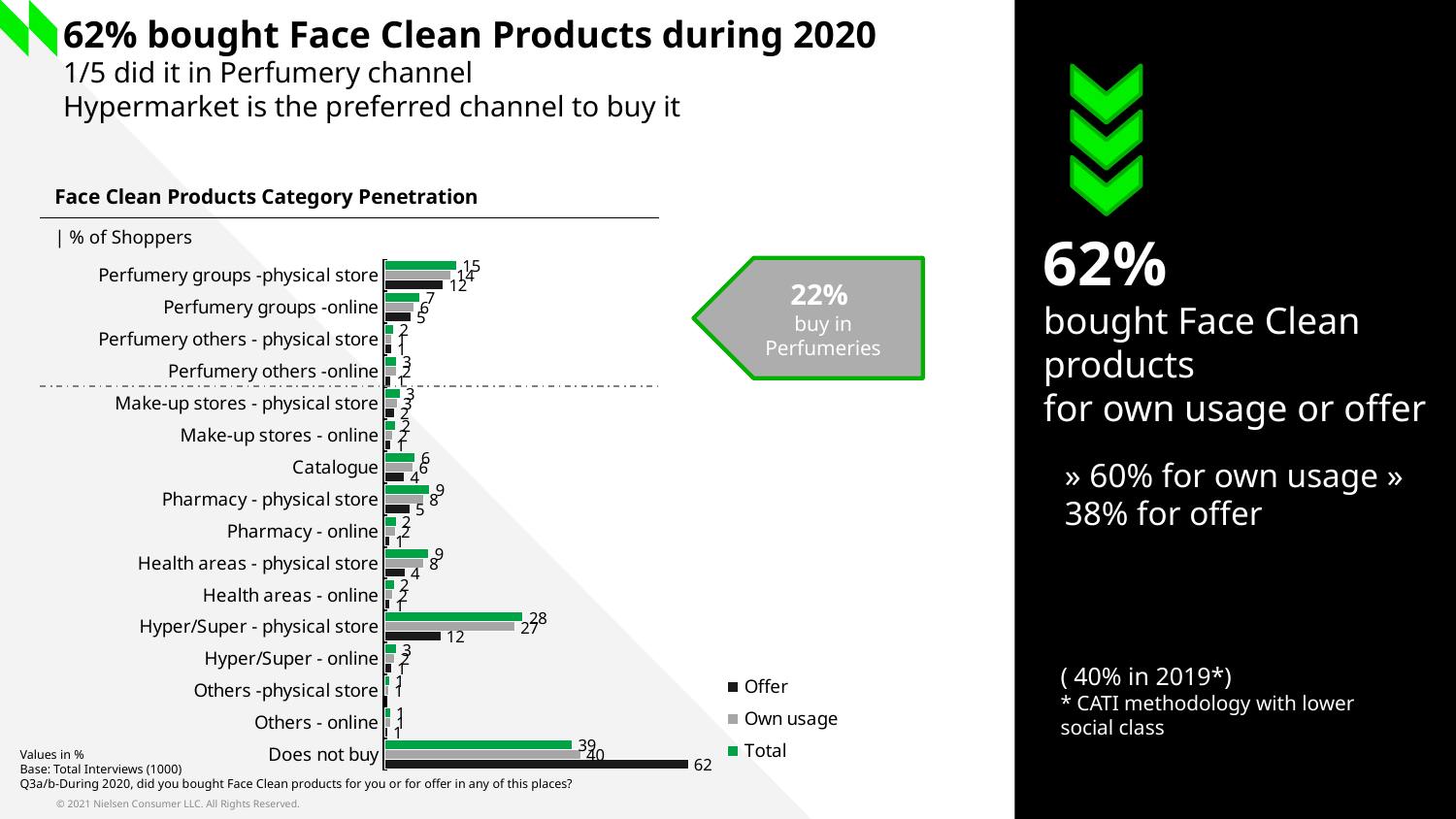
What is the Offer value for 'Does not buy'? 62 What percentage does the callout next to the chart say buy in Perfumeries? 22% Which series does the legend list: name them in order. Offer, Own usage, Total What type of chart is shown under 'Face Clean Products Category Penetration'? Bar chart How many categories are plotted on the chart? 16 How many series does the legend of the chart list? 3 Which has the larger Total value: 'Pharmacy - physical store' or 'Catalogue'? Pharmacy - physical store Excluding 'Does not buy', which category has the highest Total value? Hyper/Super - physical store What is the difference between the Total value for 'Hyper/Super - physical store' and the Total value for 'Perfumery groups - physical store'? 13 What is the Offer value for 'Hyper/Super - physical store'? 12 What is the Own usage value for 'Perfumery groups - physical store'? 14 What is the Total value for 'Hyper/Super - physical store'? 28